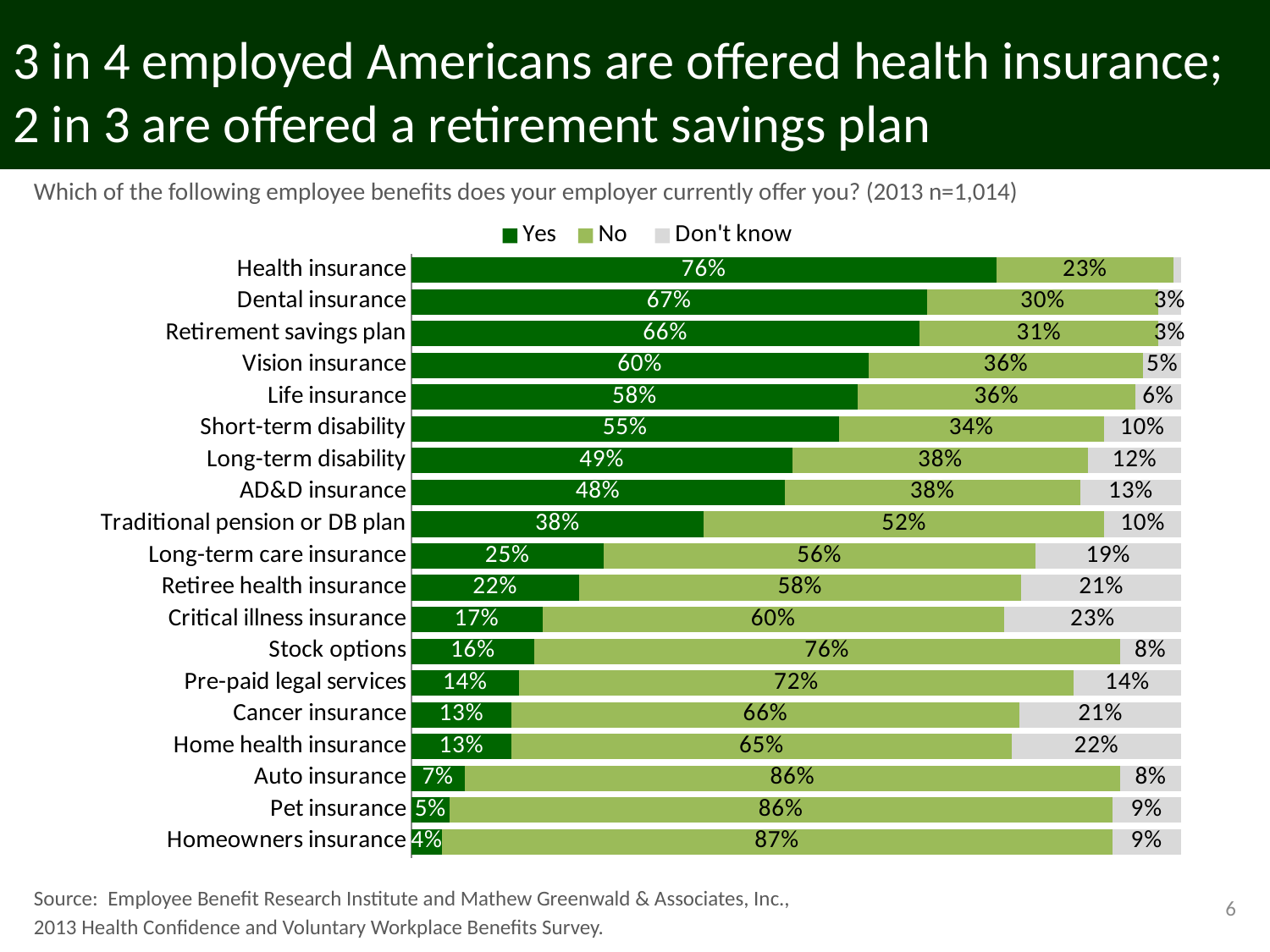
What is the Don't know value for Long-term care insurance? 19% What type of chart is shown on the slide? Stacked bar chart What percentage of respondents said Yes to being offered health insurance? 76% Which has a higher Yes value, Short-term disability or Long-term disability? Short-term disability What is the difference in percentage points between the Yes value for Health insurance and the Yes value for Retirement savings plan? 10 percentage points Which benefit has the highest Yes percentage? Health insurance What is the Yes value for Stock options? 16% How many employee benefits are listed in the chart? 19 Which benefit has the lowest Yes percentage? Homeowners insurance What is the No value for Traditional pension or DB plan? 52% How many series does the legend list? 3 Which benefit has the highest No percentage? Homeowners insurance